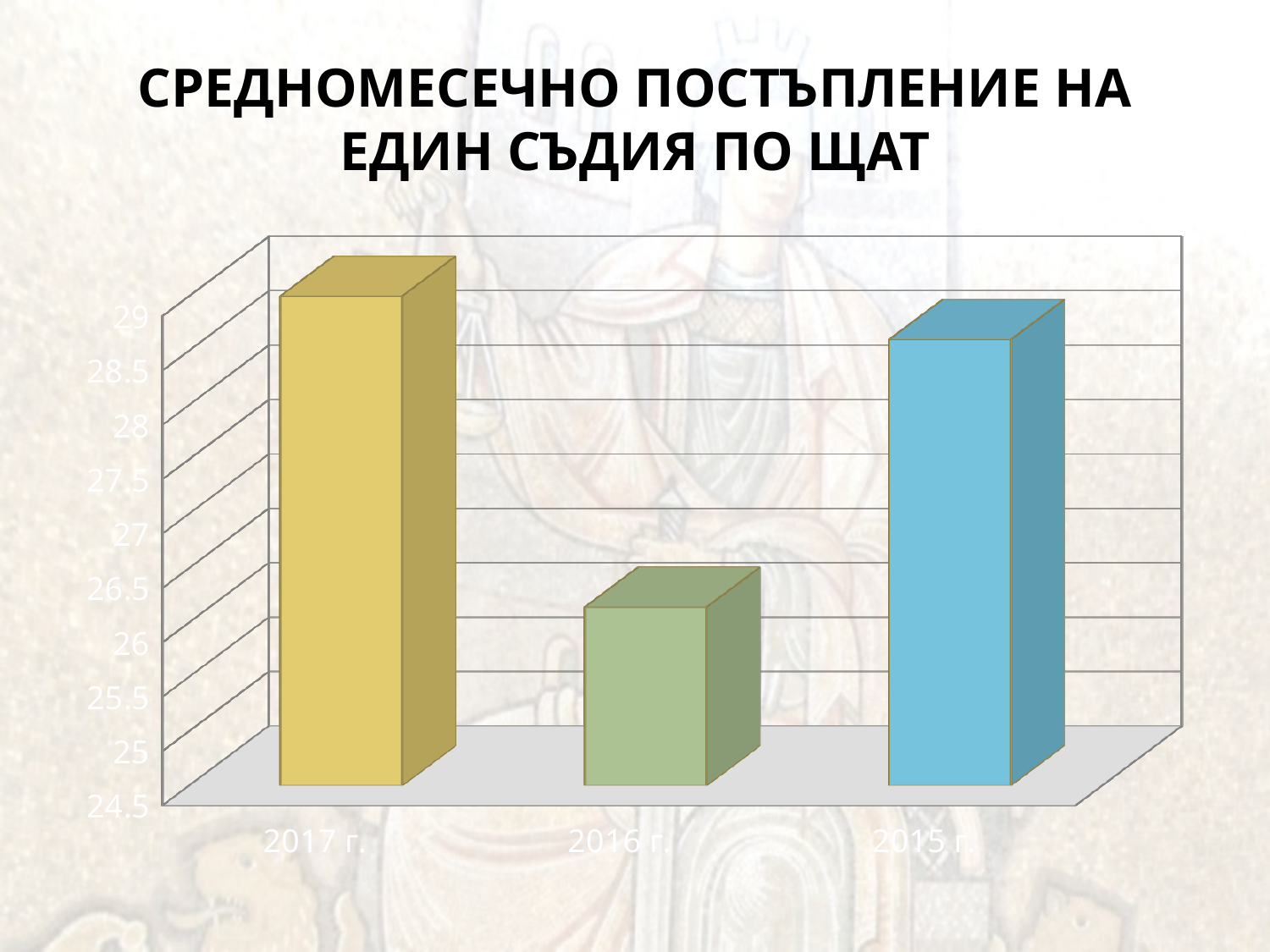
Is the value for 2015 г. greater or less than 28? greater Which year has the highest bar? 2017 г. Which is larger, the value for 2015 г. or the value for 2016 г.? 2015 г. What kind of chart is shown on the slide? bar chart Is the value for 2016 г. greater or less than 27? less What is the lowest value shown on the vertical axis? 24.5 Which year has the lowest bar? 2016 г. What is the title of the chart on the slide? СРЕДНОМЕСЕЧНО ПОСТЪПЛЕНИЕ НА ЕДИН СЪДИЯ ПО ЩАТ Is the value for 2017 г. greater or less than 28? greater How many categories (years) are shown on the x axis? 3 Which is larger, the value for 2017 г. or the value for 2016 г.? 2017 г.